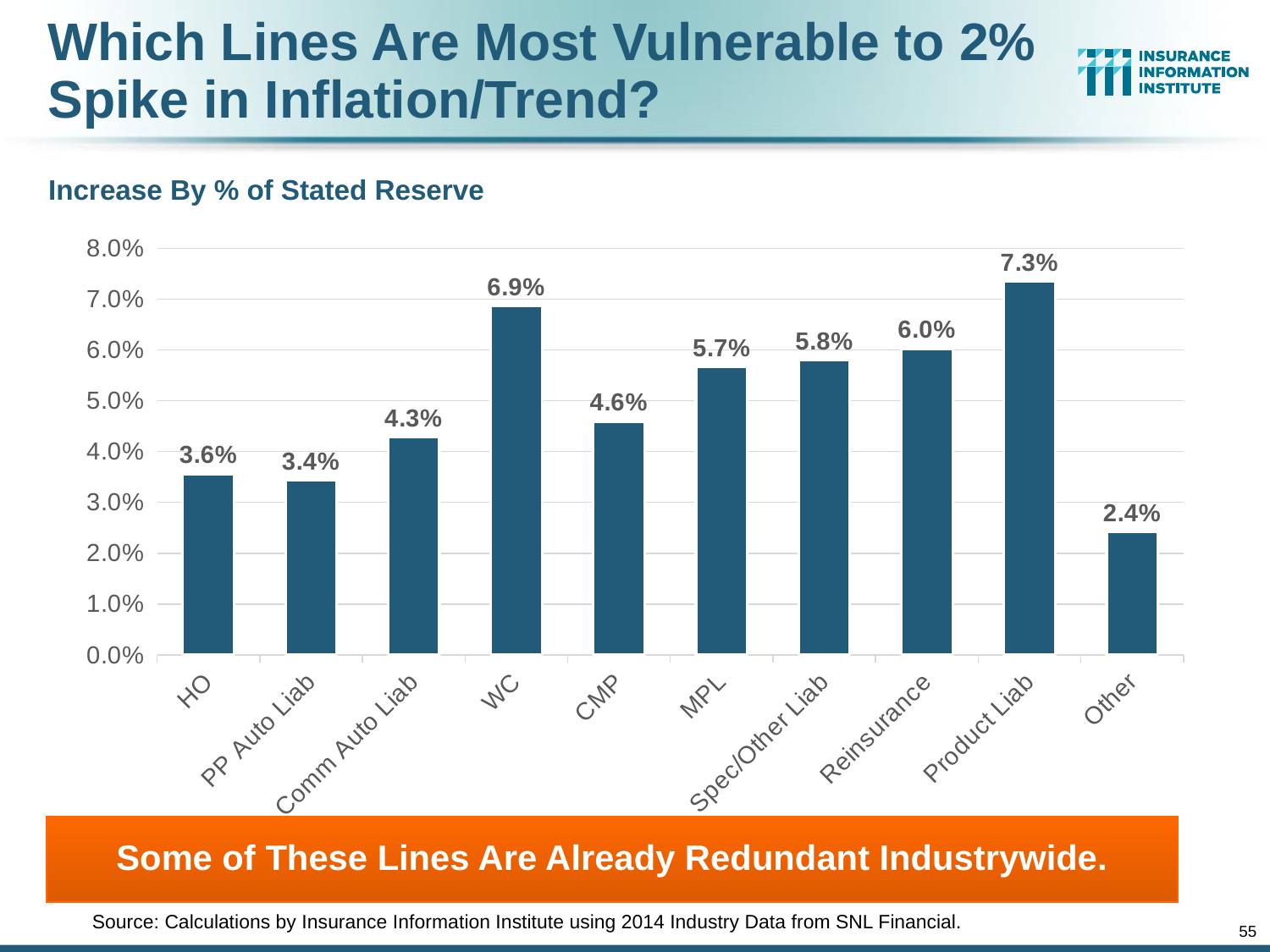
What kind of chart is shown on the slide? bar chart What is the value for Reinsurance? 6.0% What is the subtitle shown above the chart? Increase By % of Stated Reserve What is the value for PP Auto Liab? 3.4% Which category has the highest value? Product Liab What is the difference between the values for WC and CMP? 2.3% What is the difference between the values for Product Liab and Other? 4.9% Which is larger, the value for Comm Auto Liab or the value for MPL? MPL How many categories are shown on the x axis? 10 Which category has the lowest value? Other Is the value for Spec/Other Liab greater or less than 5.0%? greater What is the value for WC? 6.9%